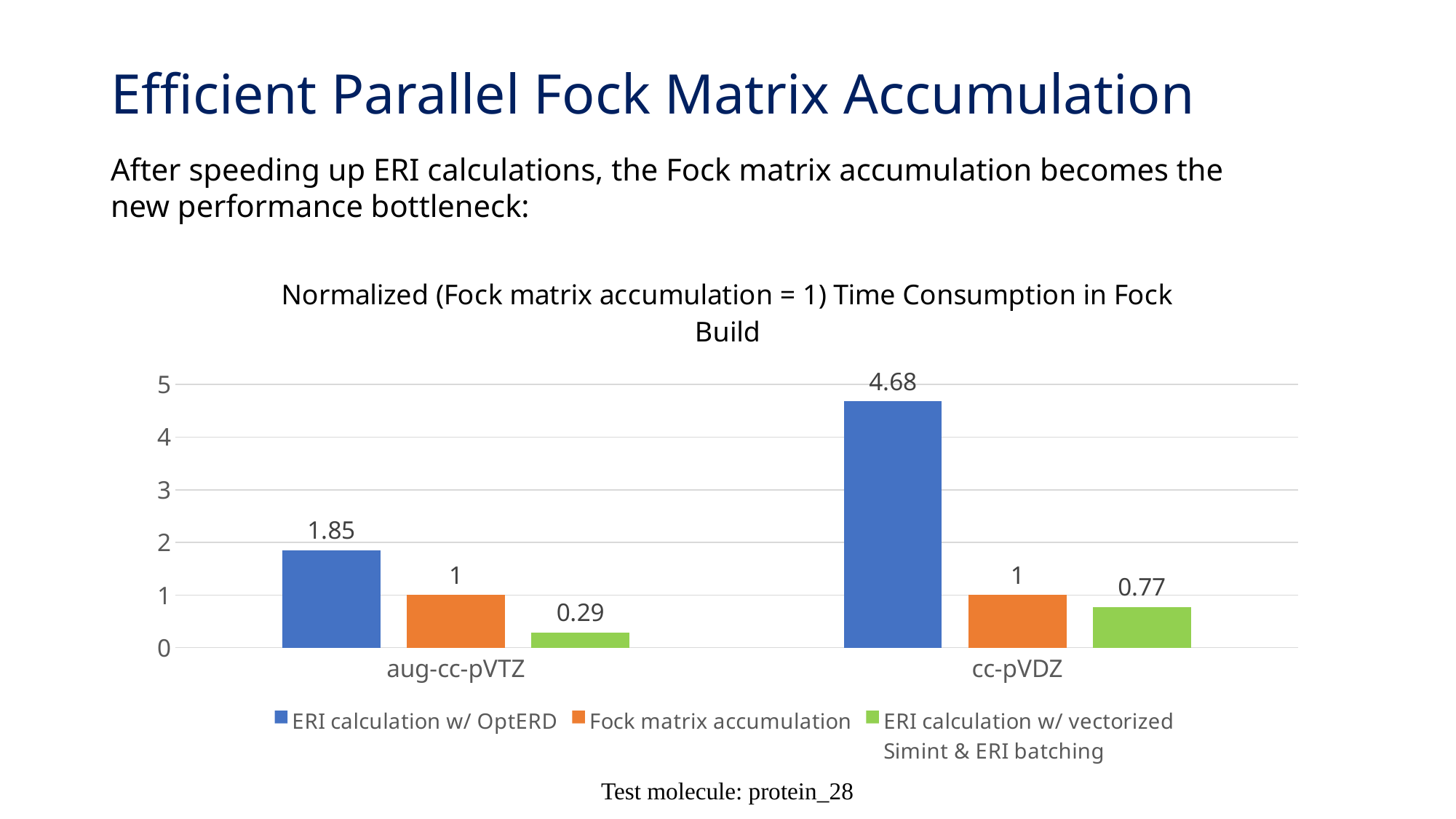
What kind of chart is shown on the slide? Bar chart What is the value for Fock matrix accumulation for cc-pVDZ? 1 What is the value for ERI calculation w/ vectorized Simint & ERI batching for cc-pVDZ? 0.77 Which series has the lowest value for aug-cc-pVTZ? ERI calculation w/ vectorized Simint & ERI batching Which is larger: ERI calculation w/ vectorized Simint & ERI batching for cc-pVDZ or for aug-cc-pVTZ? cc-pVDZ How many series does the legend list? 3 How many categories are shown on the x axis? 2 Which series has the highest value for cc-pVDZ? ERI calculation w/ OptERD What is the value for ERI calculation w/ OptERD for aug-cc-pVTZ? 1.85 What is the difference between the ERI calculation w/ OptERD values for cc-pVDZ and aug-cc-pVTZ? 2.83 What is the value for ERI calculation w/ OptERD for cc-pVDZ? 4.68 What is the value for ERI calculation w/ vectorized Simint & ERI batching for aug-cc-pVTZ? 0.29